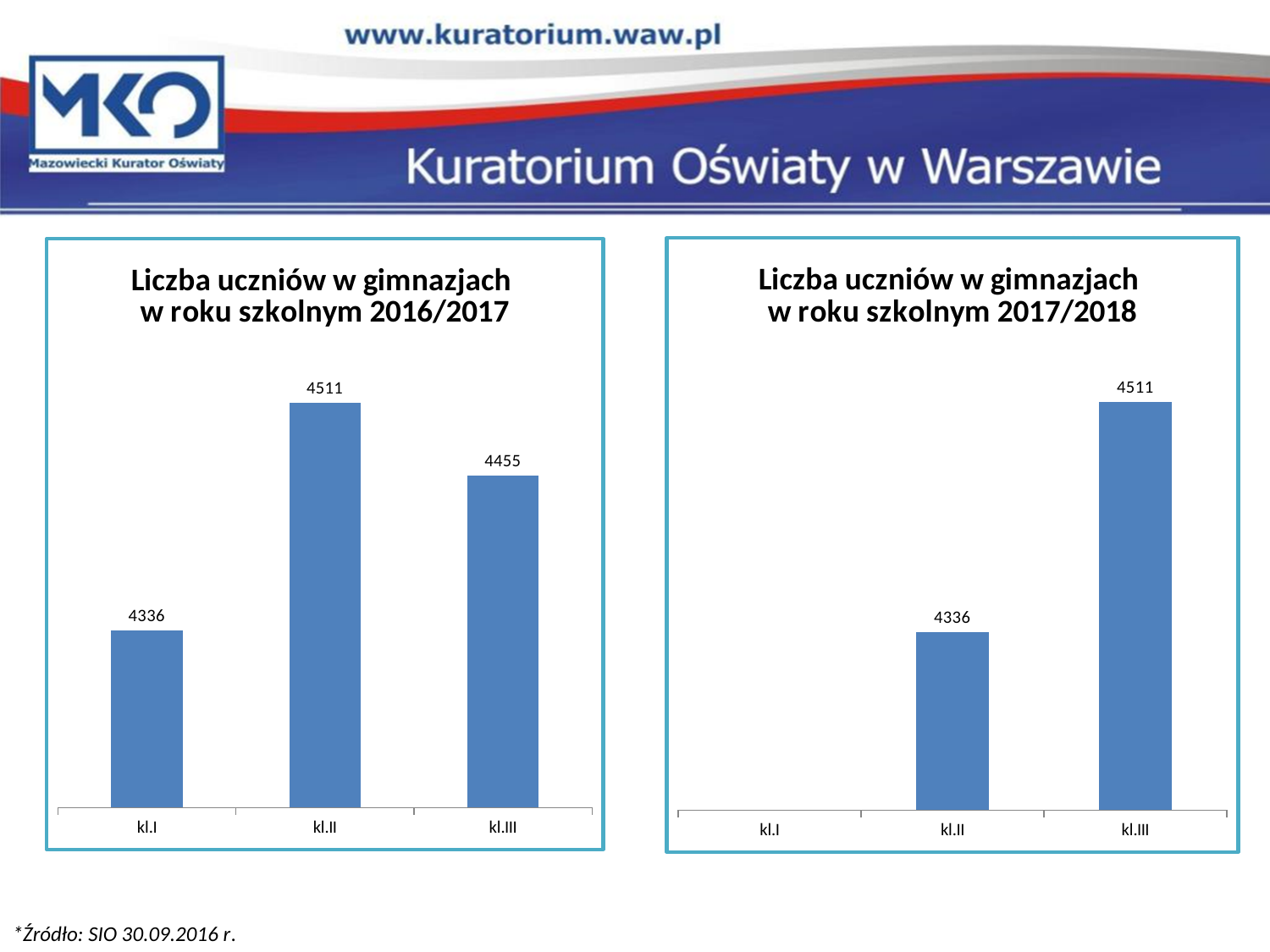
In the chart 'Liczba uczniów w gimnazjach w roku szkolnym 2016/2017', which category has the highest value? kl.II In the chart 'Liczba uczniów w gimnazjach w roku szkolnym 2016/2017', what is the value for kl.II? 4511 In the chart 'Liczba uczniów w gimnazjach w roku szkolnym 2016/2017', how many categories are shown on the x axis? 3 What kind of chart is the chart on the right, 'Liczba uczniów w gimnazjach w roku szkolnym 2017/2018'? bar chart In the chart 'Liczba uczniów w gimnazjach w roku szkolnym 2017/2018', what is the value for kl.III? 4511 In the chart 'Liczba uczniów w gimnazjach w roku szkolnym 2016/2017', which category has the lowest value? kl.I In the chart 'Liczba uczniów w gimnazjach w roku szkolnym 2016/2017', what is the value for kl.III? 4455 In the chart 'Liczba uczniów w gimnazjach w roku szkolnym 2016/2017', what is the value for kl.I? 4336 In the chart 'Liczba uczniów w gimnazjach w roku szkolnym 2017/2018', which category has the highest value? kl.III In the chart 'Liczba uczniów w gimnazjach w roku szkolnym 2016/2017', what is the difference between the values for kl.II and kl.III? 56 In the chart 'Liczba uczniów w gimnazjach w roku szkolnym 2017/2018', what is the difference between the values for kl.III and kl.II? 175 In the chart 'Liczba uczniów w gimnazjach w roku szkolnym 2017/2018', what is the value for kl.II? 4336